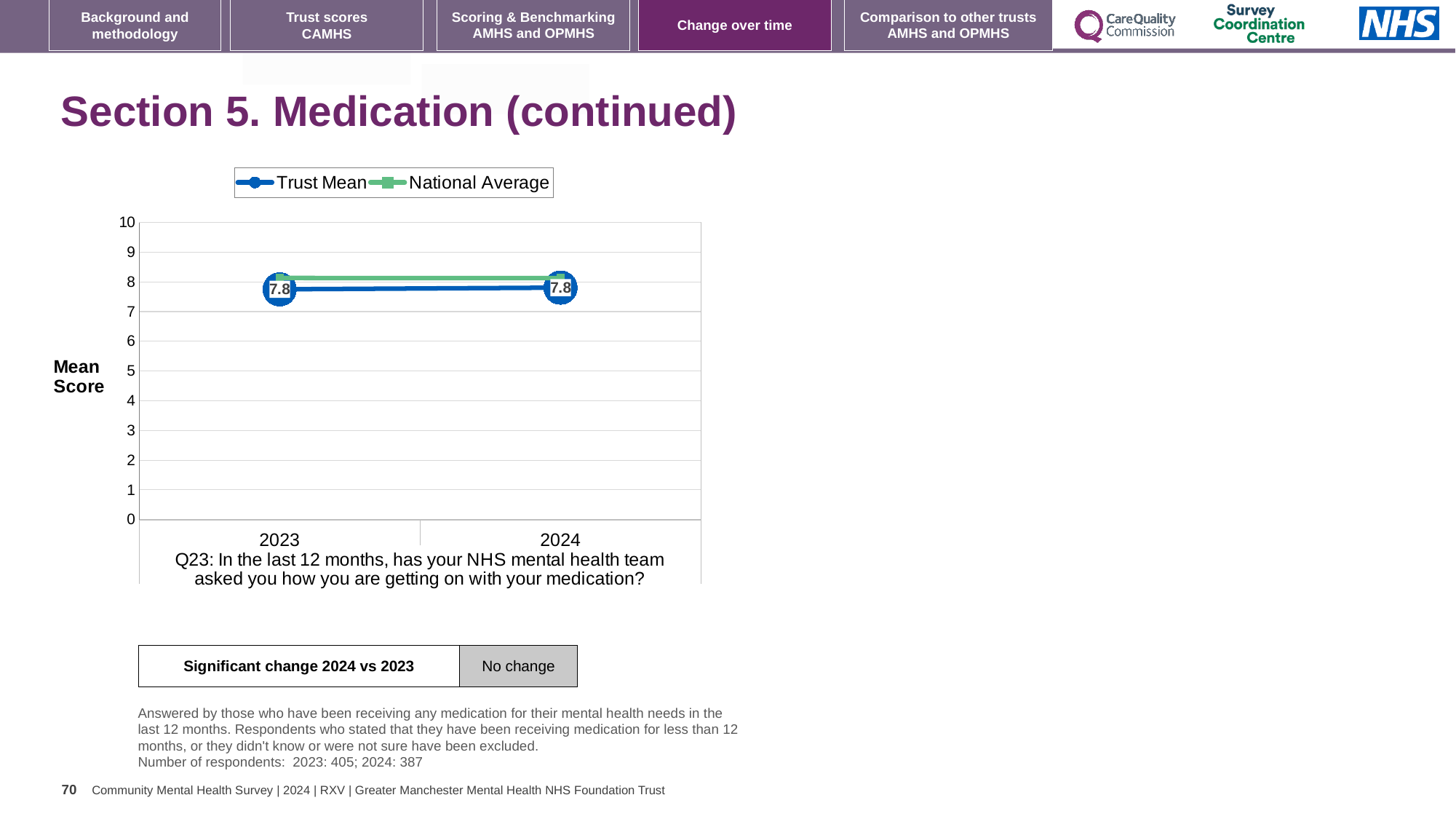
How many series does the legend list? 2 Is the National Average value for 2023 greater or less than 5? greater How many years are plotted on the x axis? 2 Which series is shown in green in the legend? National Average What is the Trust Mean score for 2024? 7.8 What is the difference between the Trust Mean scores for 2024 and 2023? 0 What kind of chart is shown on the slide? Line chart In 2024, which is higher: the Trust Mean or the National Average? National Average What is the Trust Mean score for 2023? 7.8 What is the label on the y axis of the chart? Mean Score Is the National Average value for 2024 greater or less than 9? less Does the Trust Mean rise, fall or stay the same from 2023 to 2024? Stays the same